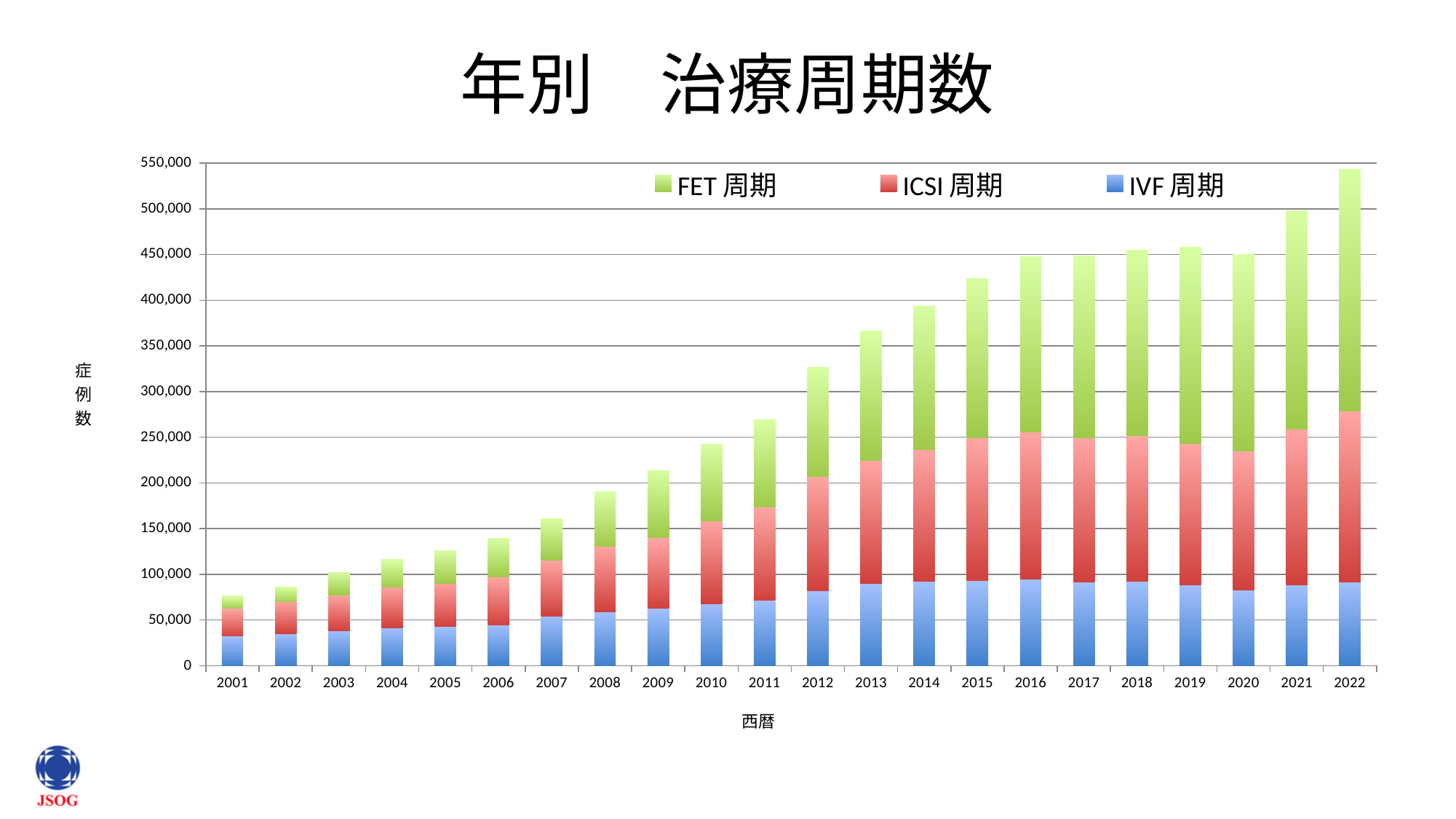
What is the title of the chart? 年別 治療周期数 Is the total value for 2022 greater or less than 500,000? greater Which year has the lowest total number of treatment cycles? 2001 How many series does the legend list? 3 Is the total value for 2001 greater or less than 100,000? less Which year has the larger total, 2020 or 2021? 2021 Which year has the highest total number of treatment cycles? 2022 Which series is shown in green in the legend? FET 周期 How many years are shown along the x axis? 22 Do the total treatment cycles generally rise or fall from 2001 to 2022? Rise What kind of chart is shown on the slide? Stacked bar chart Is the total value for 2012 greater or less than 300,000? greater